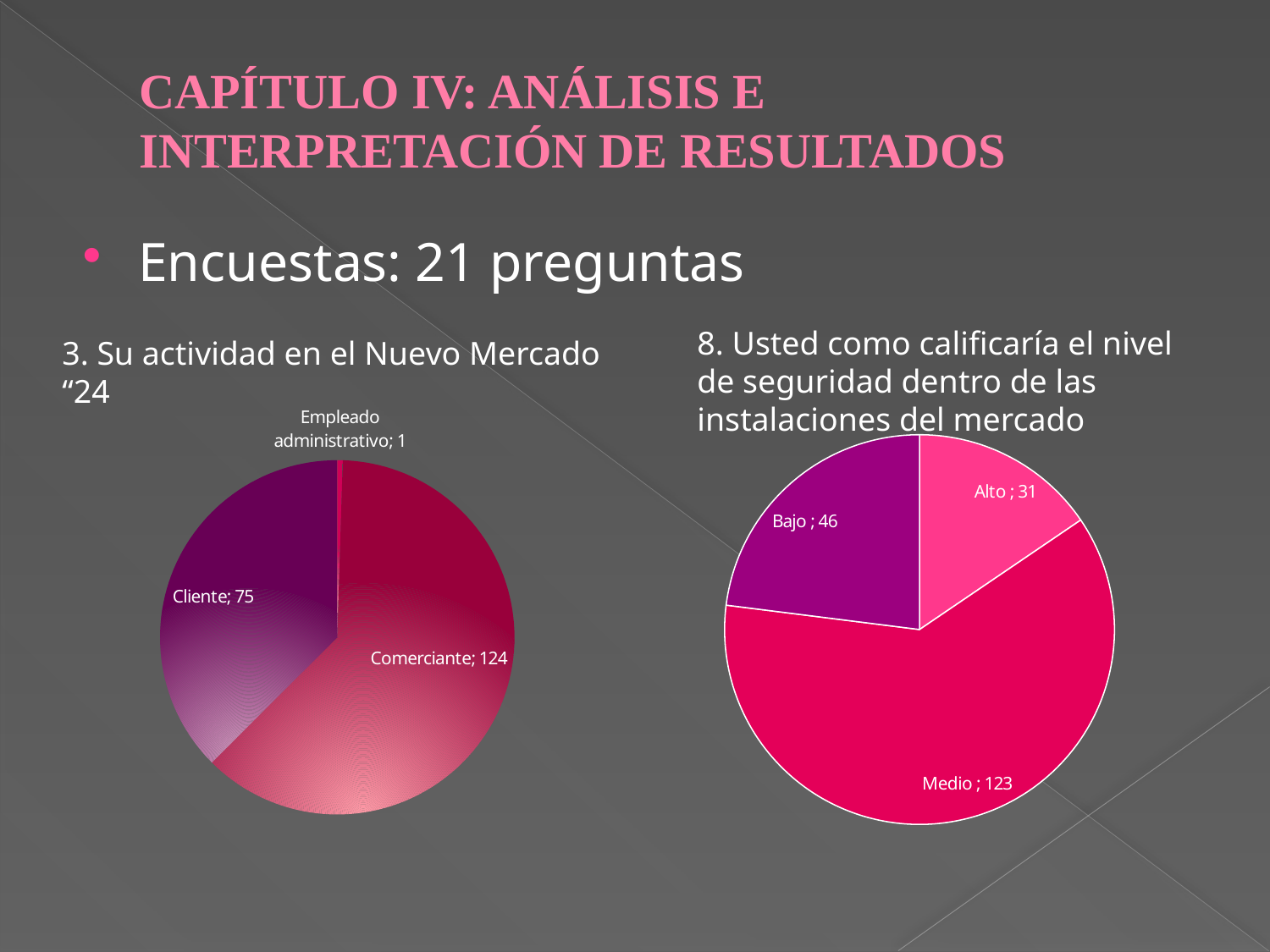
In the left pie chart (3. Su actividad en el Nuevo Mercado), which category has the smallest slice? Empleado administrativo In the left pie chart (3. Su actividad en el Nuevo Mercado), what share of the total does Comerciante represent? 62% In the right pie chart (8. nivel de seguridad), what is the value for Medio? 123 In the right pie chart (8. nivel de seguridad), what is the value for Bajo? 46 In the left pie chart (3. Su actividad en el Nuevo Mercado), what is the value for Cliente? 75 In the left pie chart (3. Su actividad en el Nuevo Mercado), what is the difference between Comerciante and Cliente? 49 What type of chart is used on the right side of the slide (8. nivel de seguridad)? Pie chart In the right pie chart (8. nivel de seguridad), which is larger, Alto or Bajo? Bajo In the left pie chart (3. Su actividad en el Nuevo Mercado), what is the value for Comerciante? 124 In the right pie chart (8. nivel de seguridad), how many categories are shown? 3 In the left pie chart (3. Su actividad en el Nuevo Mercado), what is the value for Empleado administrativo? 1 In the left pie chart (3. Su actividad en el Nuevo Mercado), which category has the largest slice? Comerciante